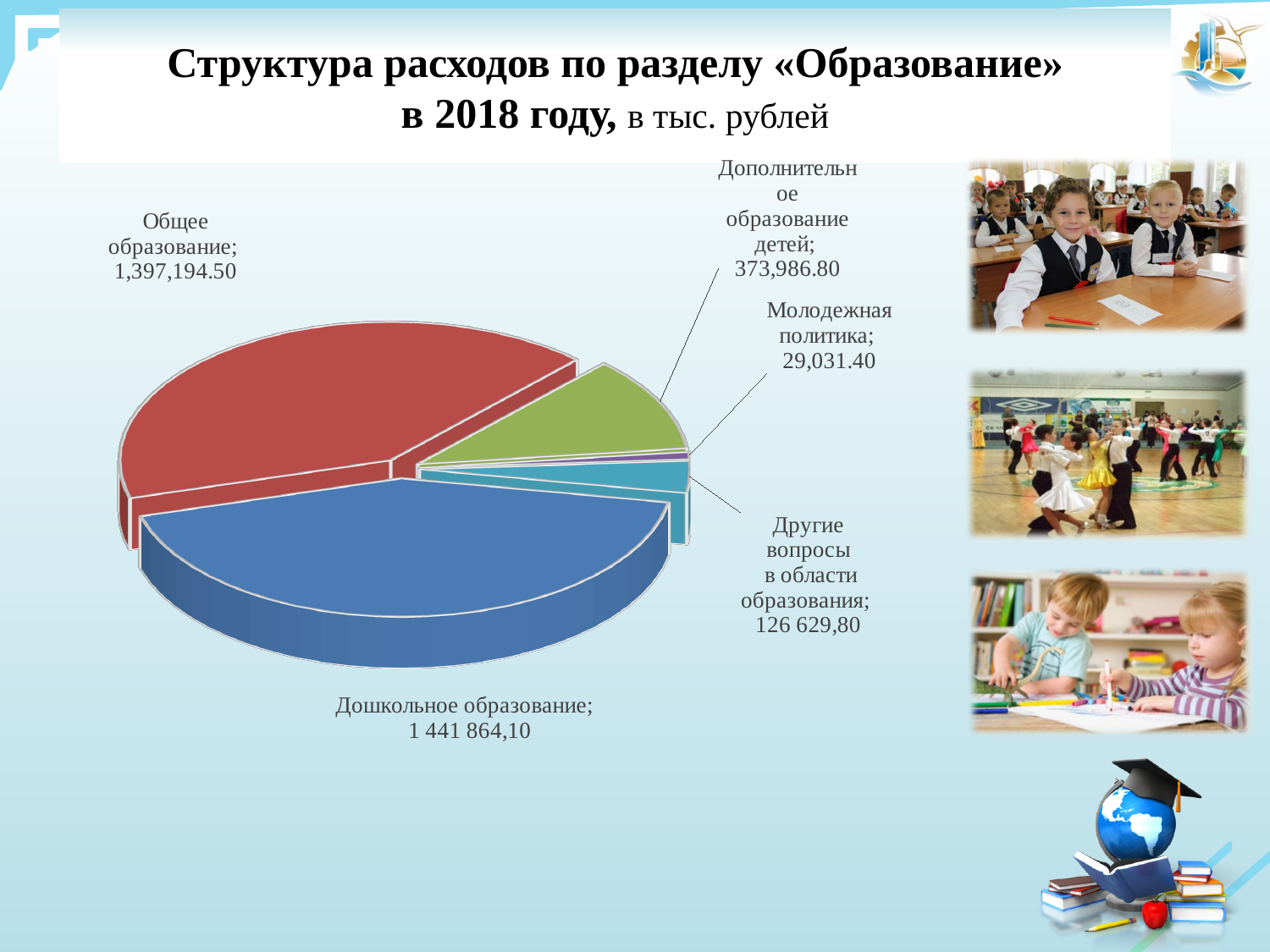
What is the difference between Общее образование and Дополнительное образование детей? 1,023,207.70 What is the value for Общее образование? 1,397,194.50 What kind of chart is shown on the slide? pie chart What is the value for Дополнительное образование детей? 373,986.80 In what units are the values in the chart expressed, according to the title? тыс. рублей What is the value for Молодежная политика? 29,031.40 Which is larger: Дополнительное образование детей or Другие вопросы в области образования? Дополнительное образование детей What is the value for Дошкольное образование? 1 441 864,10 Which category has the smallest value in the pie chart? Молодежная политика Which category has the largest value in the pie chart? Дошкольное образование How many slices does the pie chart have? 5 What is the value for Другие вопросы в области образования? 126 629,80